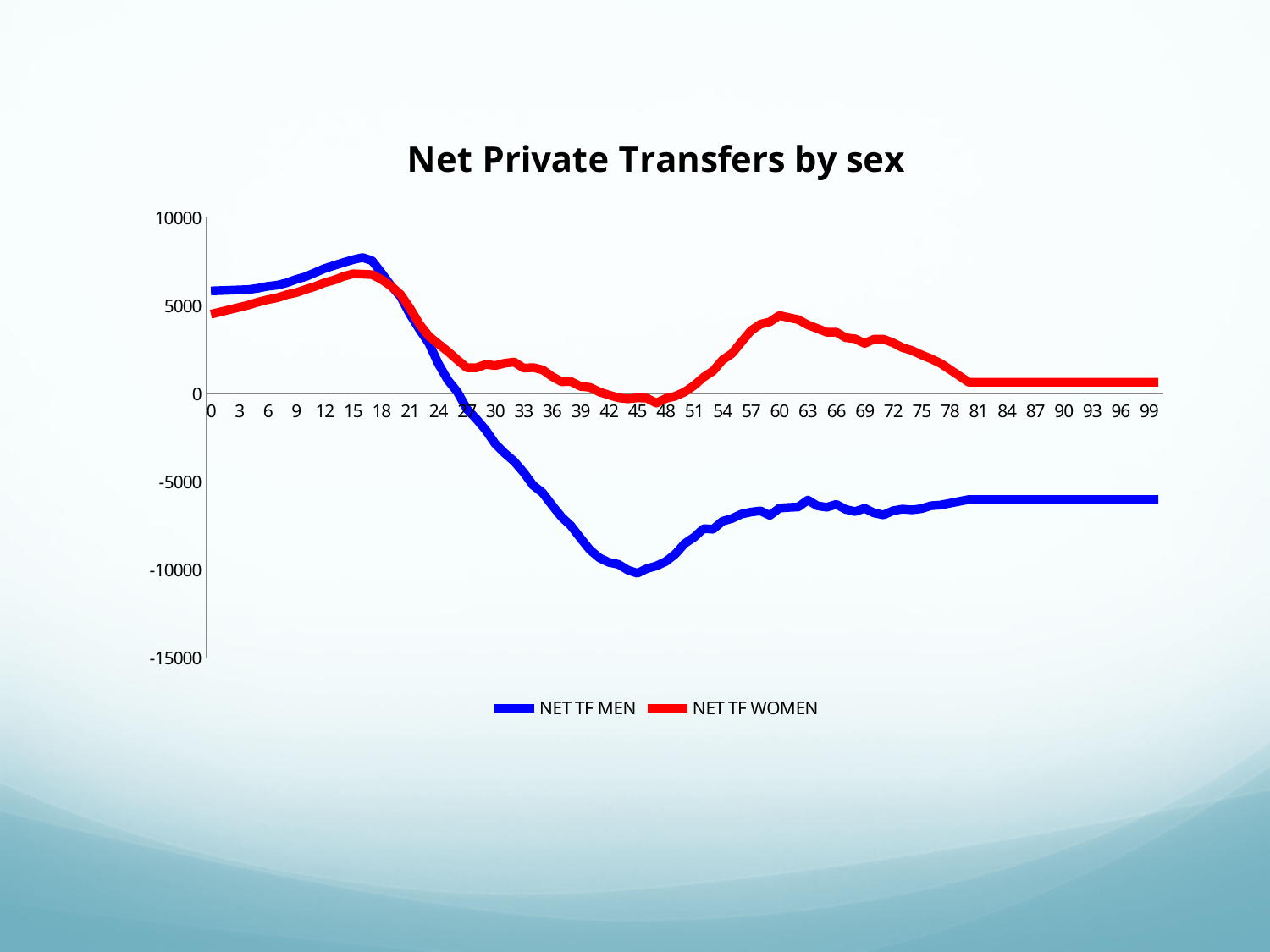
What is the title of the chart? Net Private Transfers by sex At age 45, which series has the higher value, NET TF MEN or NET TF WOMEN? NET TF WOMEN Is the value for NET TF WOMEN at age 60 greater or less than 0? greater Is the value for NET TF WOMEN at age 90 greater or less than 5000? less Does the NET TF MEN line rise or fall between age 18 and age 45? fall At age 15, which series has the higher value, NET TF MEN or NET TF WOMEN? NET TF MEN What kind of chart is shown on the slide? line chart Which series reaches the lowest value on the chart? NET TF MEN Is the value for NET TF MEN at age 0 greater or less than 5000? greater How many series does the legend list? 2 What colour is the NET TF WOMEN line? red